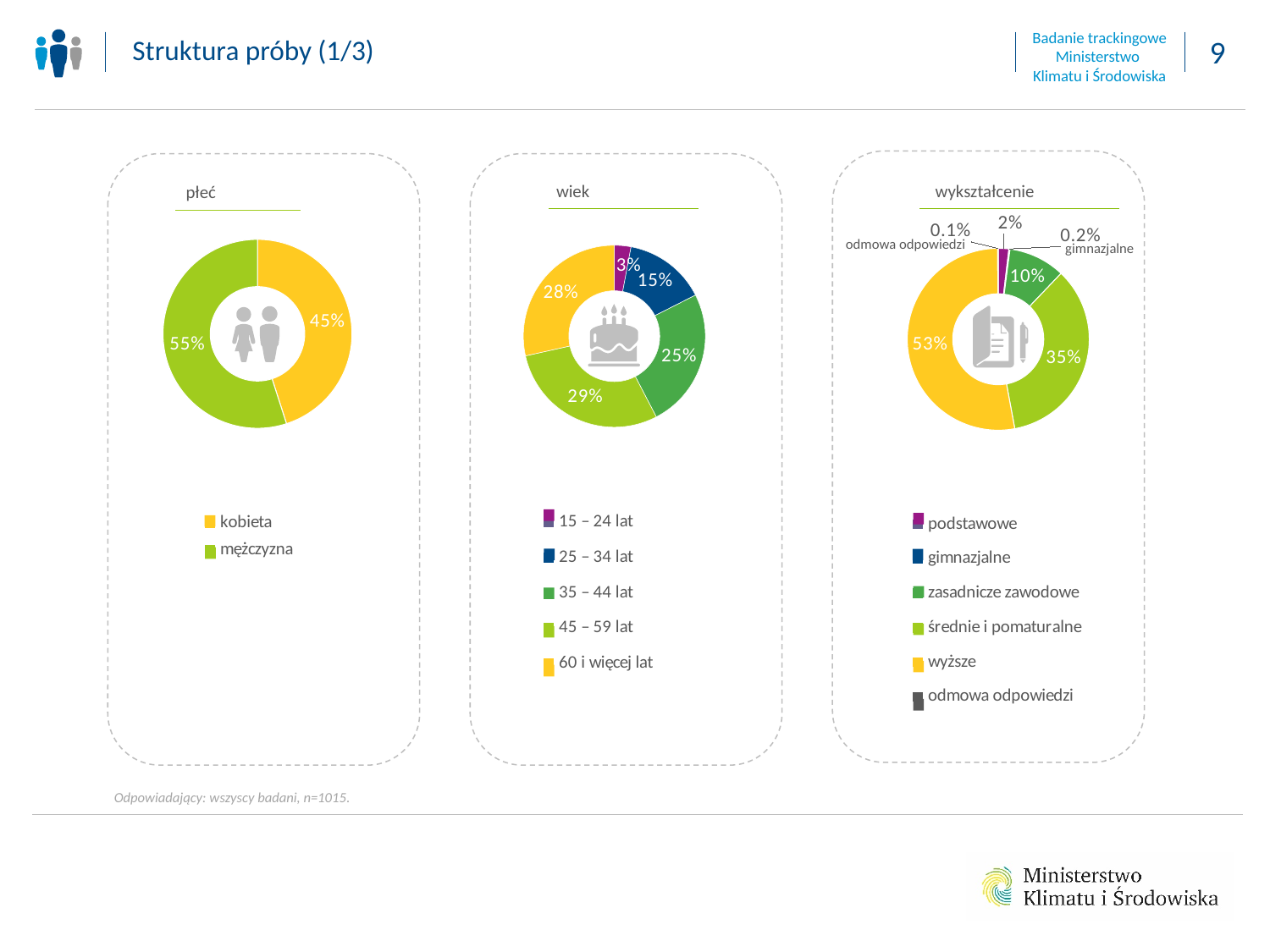
In the 'wiek' chart, which age group has the largest share? 45 – 59 lat In the 'wykształcenie' chart, what percentage is shown for odmowa odpowiedzi? 0.1% In the 'wykształcenie' chart, what percentage is shown for gimnazjalne? 0.2% In the 'płeć' chart, what percentage is shown for mężczyzna? 55% What type of chart is used for the 'płeć' data? Pie (donut) chart In the 'płeć' chart, what percentage is shown for kobieta? 45% In the 'wiek' chart, which age group has the smallest share? 15 – 24 lat In the 'wiek' chart, how many age categories does the legend list? 5 In the 'wykształcenie' chart, what percentage is shown for wyższe? 53% In the 'wykształcenie' chart, which is larger: zasadnicze zawodowe or średnie i pomaturalne? średnie i pomaturalne In the 'płeć' chart, what is the difference between the mężczyzna and kobieta shares? 10 percentage points In the 'wiek' chart, what percentage is shown for 25 – 34 lat? 15%